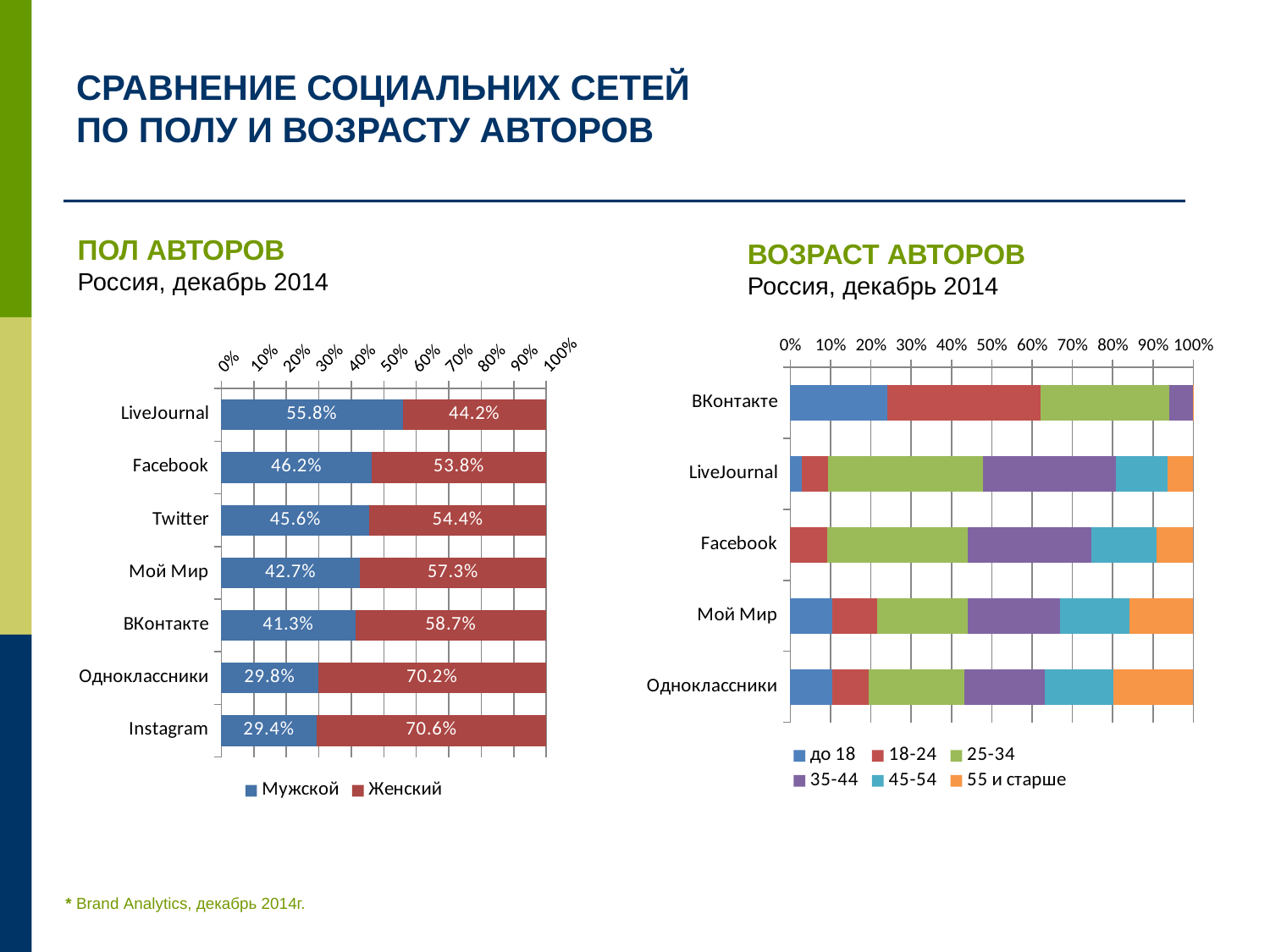
In the ПОЛ АВТОРОВ chart, what is the difference between the Женский and Мужской shares for Мой Мир? 14.6% In the ВОЗРАСТ АВТОРОВ chart, is the 'до 18' share for ВКонтакте greater or less than 10%? greater In the ПОЛ АВТОРОВ chart, what is the Мужской share for LiveJournal? 55.8% In the ПОЛ АВТОРОВ chart, which social network has the highest Женский share? Instagram In the ПОЛ АВТОРОВ chart, how many social networks are shown? 7 In the ВОЗРАСТ АВТОРОВ chart, which social network has the largest 'до 18' segment? ВКонтакте In the ПОЛ АВТОРОВ chart, what is the Женский share for Одноклассники? 70.2% In the ПОЛ АВТОРОВ chart, which is larger: the Мужской share for Facebook or for Twitter? Facebook In the ПОЛ АВТОРОВ chart, which social network has the lowest Мужской share? Instagram In the ПОЛ АВТОРОВ chart, what is the total of the Мужской and Женский shares for ВКонтакте? 100% In the ВОЗРАСТ АВТОРОВ chart, how many series does the legend list? 6 What kind of chart is the ВОЗРАСТ АВТОРОВ chart? Stacked bar chart